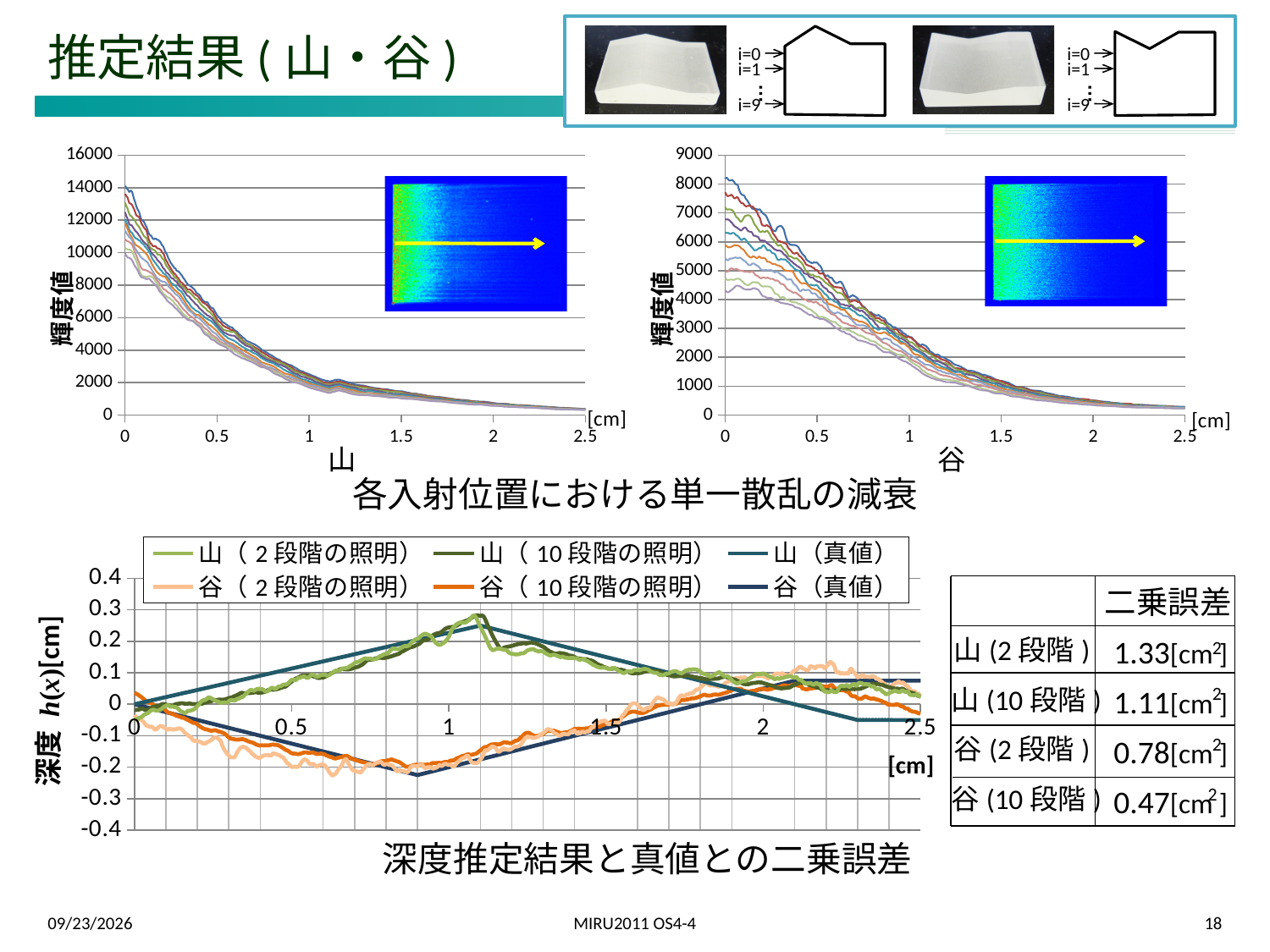
How many series does the legend of the bottom chart list? 6 What type of chart is the top-left chart labelled 山? line chart In the top-left chart (山), is the highest value at x = 0 greater or less than 12000? greater In the top-right chart (谷), is the highest value at x = 0 greater or less than 7000? greater In the top-right chart (谷), is the lowest value at x = 0 greater or less than 5000? less What is the maximum value shown on the y axis of the top-right chart (谷)? 9000 What type of chart is the bottom chart (深度推定結果と真値との二乗誤差)? line chart In the top-right chart (谷), do the plotted values rise or fall as the x axis increases from 0 to 2.5 cm? fall In the top-left chart (山), do the plotted values rise or fall as the x axis increases from 0 to 2.5 cm? fall